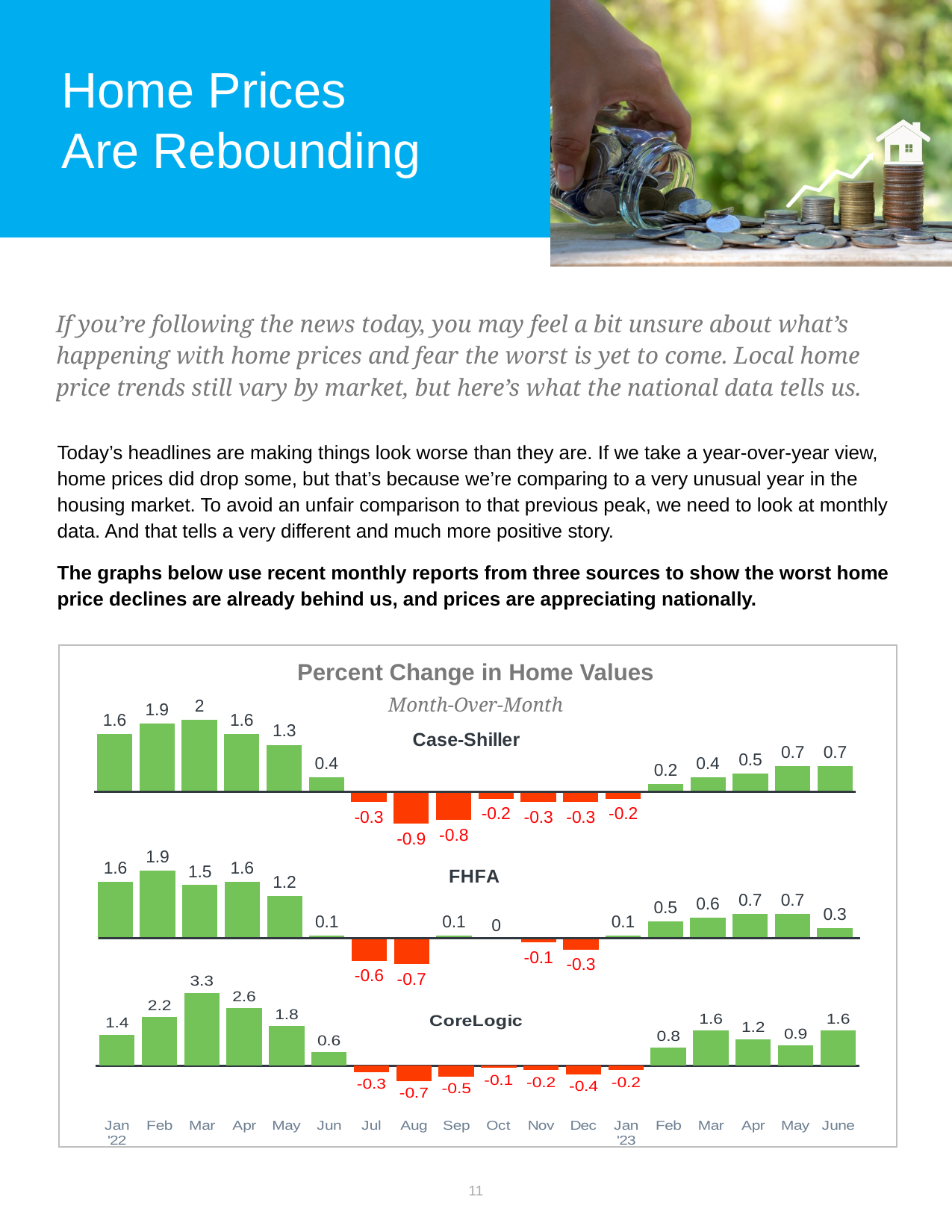
In the CoreLogic chart, which is larger, the value for Feb '23 or the value for Mar '23? Mar '23 In the Case-Shiller chart, what is the value for Aug? -0.9 In the FHFA chart, what is the value for Feb '23? 0.5 In the CoreLogic chart, what is the value for Mar '22? 3.3 In the CoreLogic chart, which month has the highest value? Mar '22 How many months are shown on the x axis of each chart? 18 In the Case-Shiller chart, what is the difference between the values for Mar '22 and Jun? 1.6 What is the subtitle of the Percent Change in Home Values chart? Month-Over-Month What kind of chart is used to show the Percent Change in Home Values? Bar chart In the FHFA chart, which month has the lowest value? Aug In the Case-Shiller chart, do the values rise or fall from Jan '23 to June? Rise In the Case-Shiller chart, which month has the lowest value? Aug